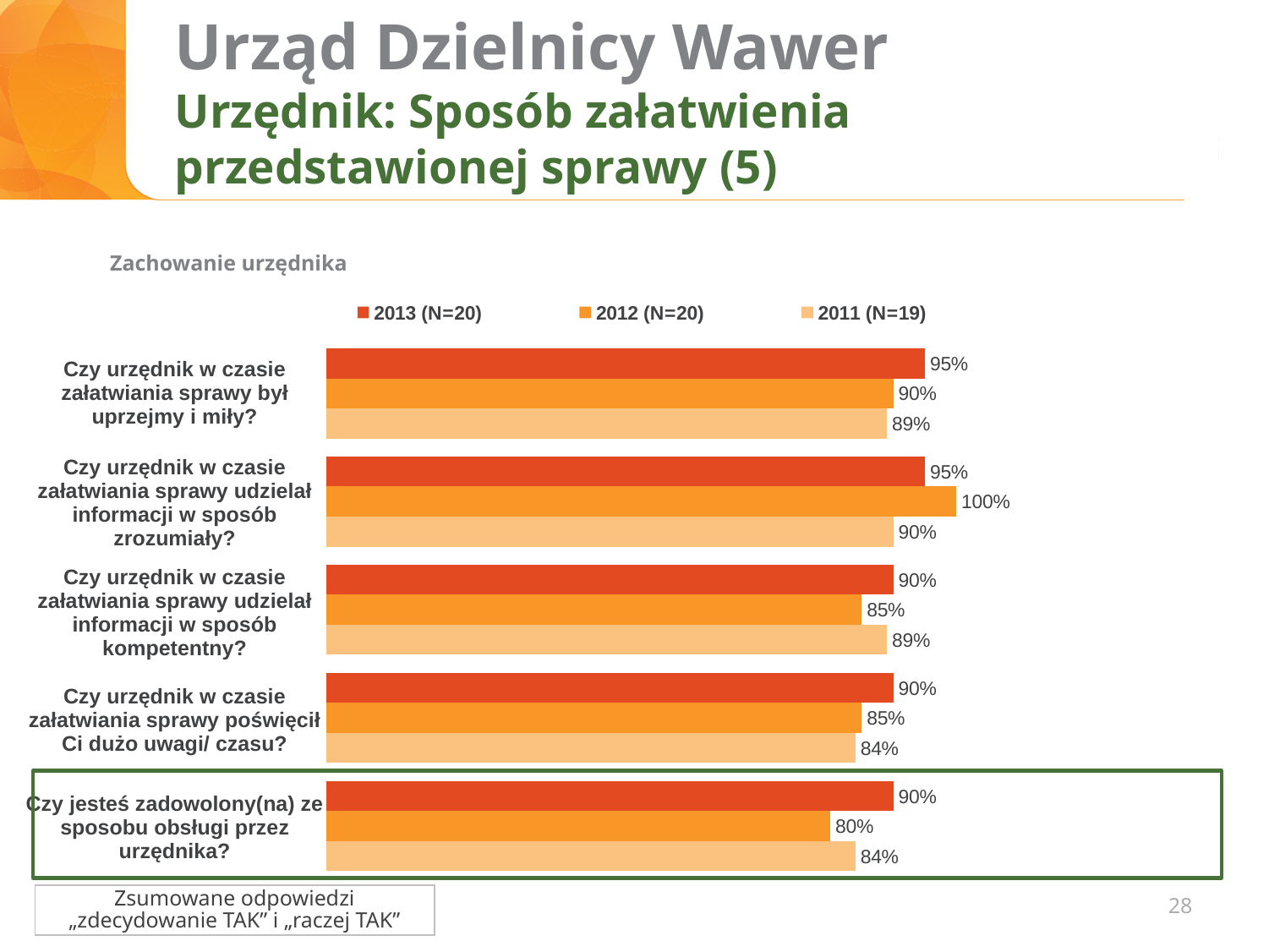
What type of chart is shown on the slide? bar chart What is the subtitle shown above the chart? Zachowanie urzędnika For "Czy urzędnik w czasie załatwiania sprawy udzielał informacji w sposób kompetentny?", which is larger: the 2012 (N=20) value or the 2011 (N=19) value? 2011 (N=19) What is the 2012 (N=20) value for "Czy urzędnik w czasie załatwiania sprawy poświęcił Ci dużo uwagi/ czasu?"? 85% What is the 2013 (N=20) value for "Czy urzędnik w czasie załatwiania sprawy był uprzejmy i miły?"? 95% How many series does the legend list? 3 Which category has the lowest 2012 (N=20) value? Czy jesteś zadowolony(na) ze sposobu obsługi przez urzędnika? Which category has the highest 2012 (N=20) value? Czy urzędnik w czasie załatwiania sprawy udzielał informacji w sposób zrozumiały? How many question categories are plotted in the chart? 5 What is the 2012 (N=20) value for "Czy urzędnik w czasie załatwiania sprawy udzielał informacji w sposób zrozumiały?"? 100% What is the difference between the 2013 (N=20) and 2012 (N=20) values for "Czy jesteś zadowolony(na) ze sposobu obsługi przez urzędnika?"? 10% What is the 2011 (N=19) value for "Czy jesteś zadowolony(na) ze sposobu obsługi przez urzędnika?"? 84%